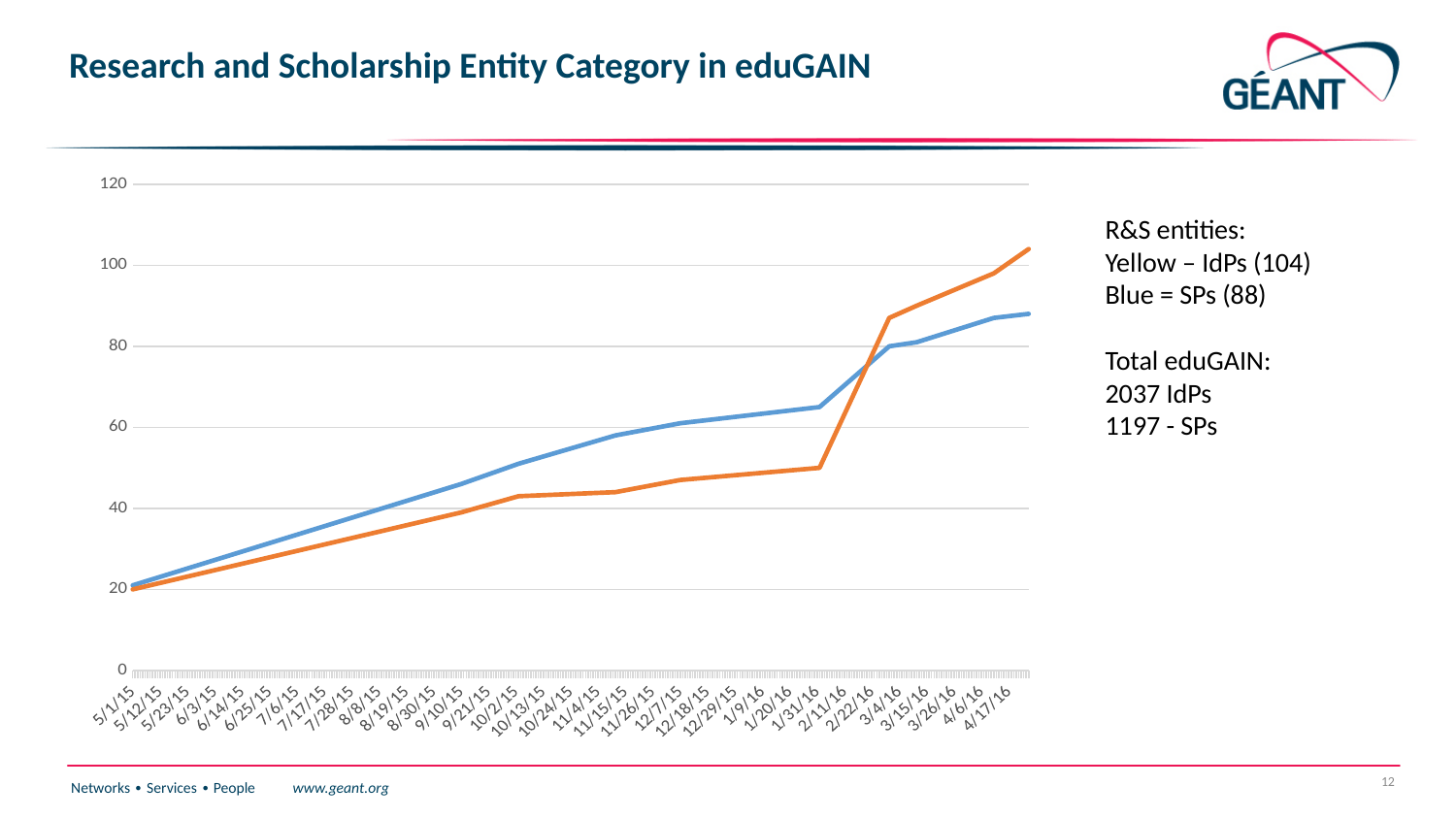
According to the text beside the chart, what is the number of R&S SPs? 88 What is the difference between the number of R&S IdPs (104) and R&S SPs (88)? 16 Is the value of the SPs (blue) line at 4/17/16 greater or less than 100? less Is the value of the SPs (blue) line at 5/1/15 greater or less than 40? less How many lines (series) are plotted on the chart? 2 At 4/17/16, which line is higher: the IdPs (orange) line or the SPs (blue) line? IdPs (orange) At 10/13/15, which line is higher: the IdPs (orange) line or the SPs (blue) line? SPs (blue) What kind of chart is shown on the slide? line chart What is the title of the slide containing the chart? Research and Scholarship Entity Category in eduGAIN Is the value of the IdPs (orange) line at 4/17/16 greater or less than 100? greater According to the text beside the chart, what is the number of R&S IdPs? 104 Do the values of the IdPs line rise or fall from 5/1/15 to 4/17/16? rise